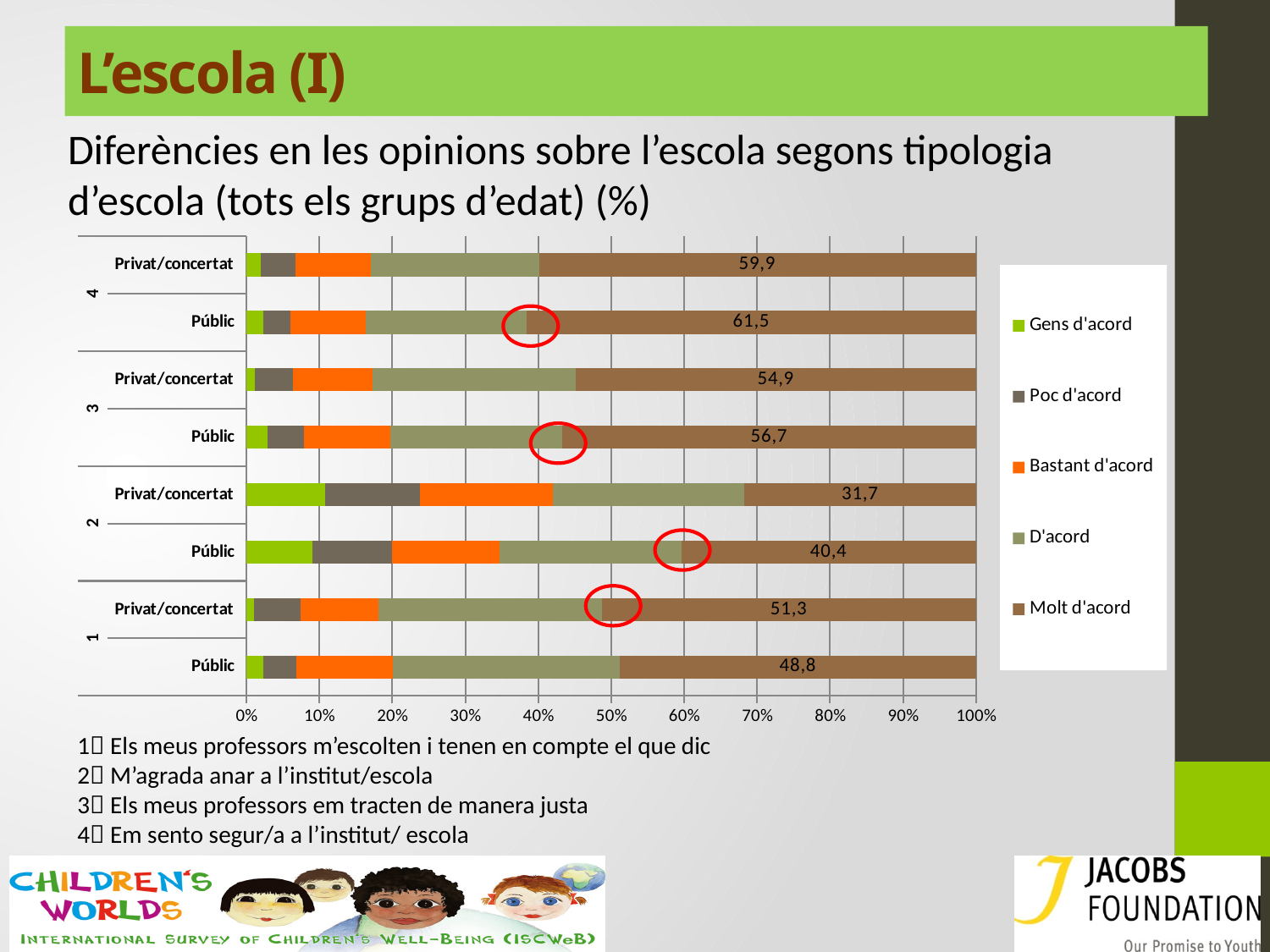
What is the 'Molt d'acord' value for Públic in item 1? 48,8 Which bar has the lowest labelled 'Molt d'acord' value? Privat/concertat, item 2 How many bars are plotted in the chart? 8 What is the 'Molt d'acord' value for Públic in item 4? 61,5 How many series does the legend list? 5 Which legend entry corresponds to the orange segments? Bastant d'acord What is the 'Molt d'acord' value for Privat/concertat in item 3? 54,9 Which bar has the highest labelled 'Molt d'acord' value? Públic, item 4 What is the difference between the 'Molt d'acord' values for Públic and Privat/concertat in item 2? 8,7 What is the 'Molt d'acord' value for Privat/concertat in item 2? 31,7 In item 1, which has the larger 'Molt d'acord' value, Públic or Privat/concertat? Privat/concertat What kind of chart is shown on the slide? Stacked bar chart